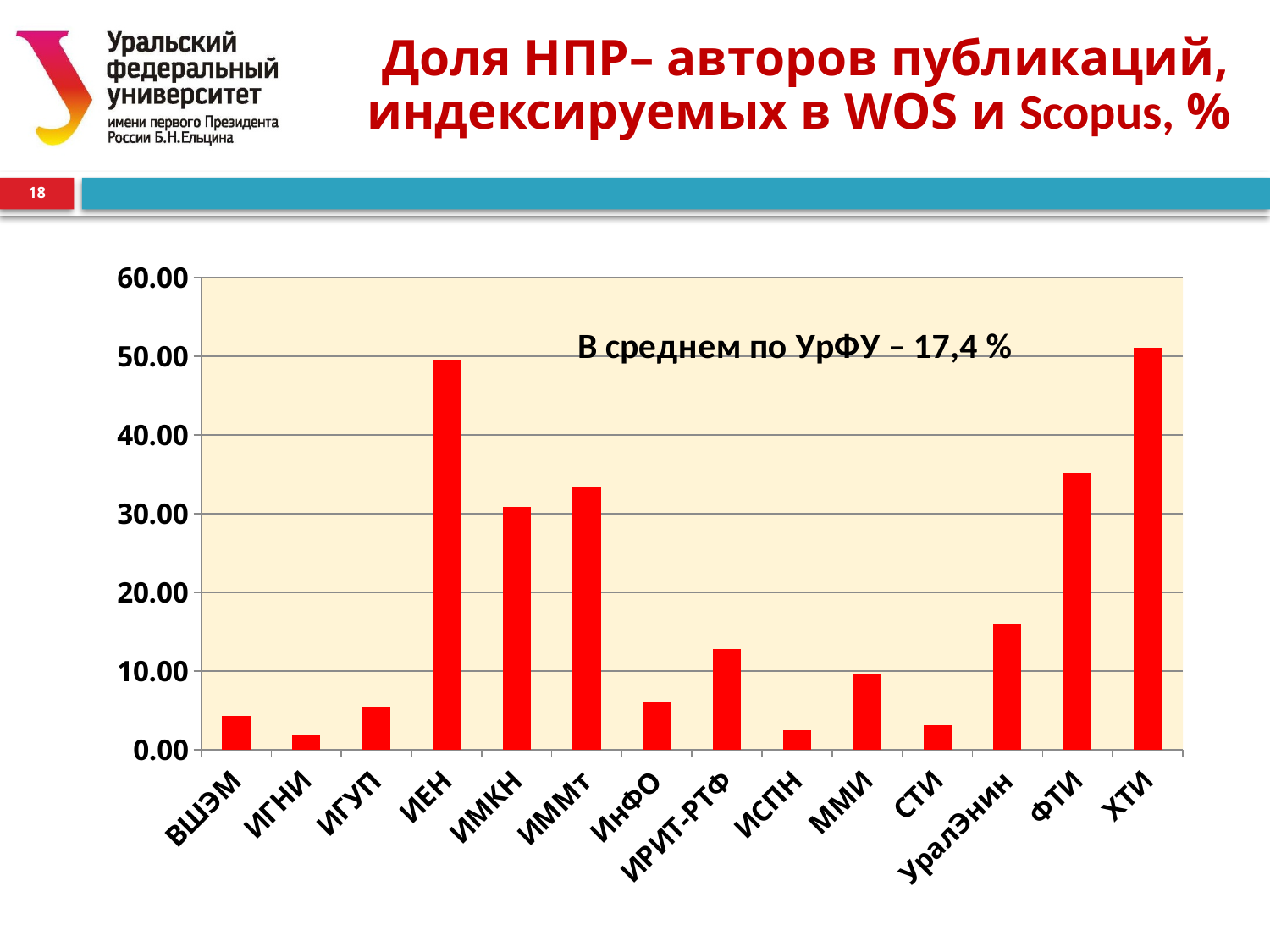
Is the value for ИРИТ-РТФ greater or less than 10? greater Is the value for ХТИ greater or less than 50? greater What kind of chart is shown on the slide? bar chart What average value for УрФУ is stated in the text on the chart? 17,4 % Which has a larger value, ИГУП or СТИ? ИГУП Which has a larger value, ИММт or ИМКН? ИММт Is the value for ИЕН greater or less than 40? greater How many categories (institutes) are shown on the x axis of the chart? 14 Which institute has the highest value in the chart? ХТИ